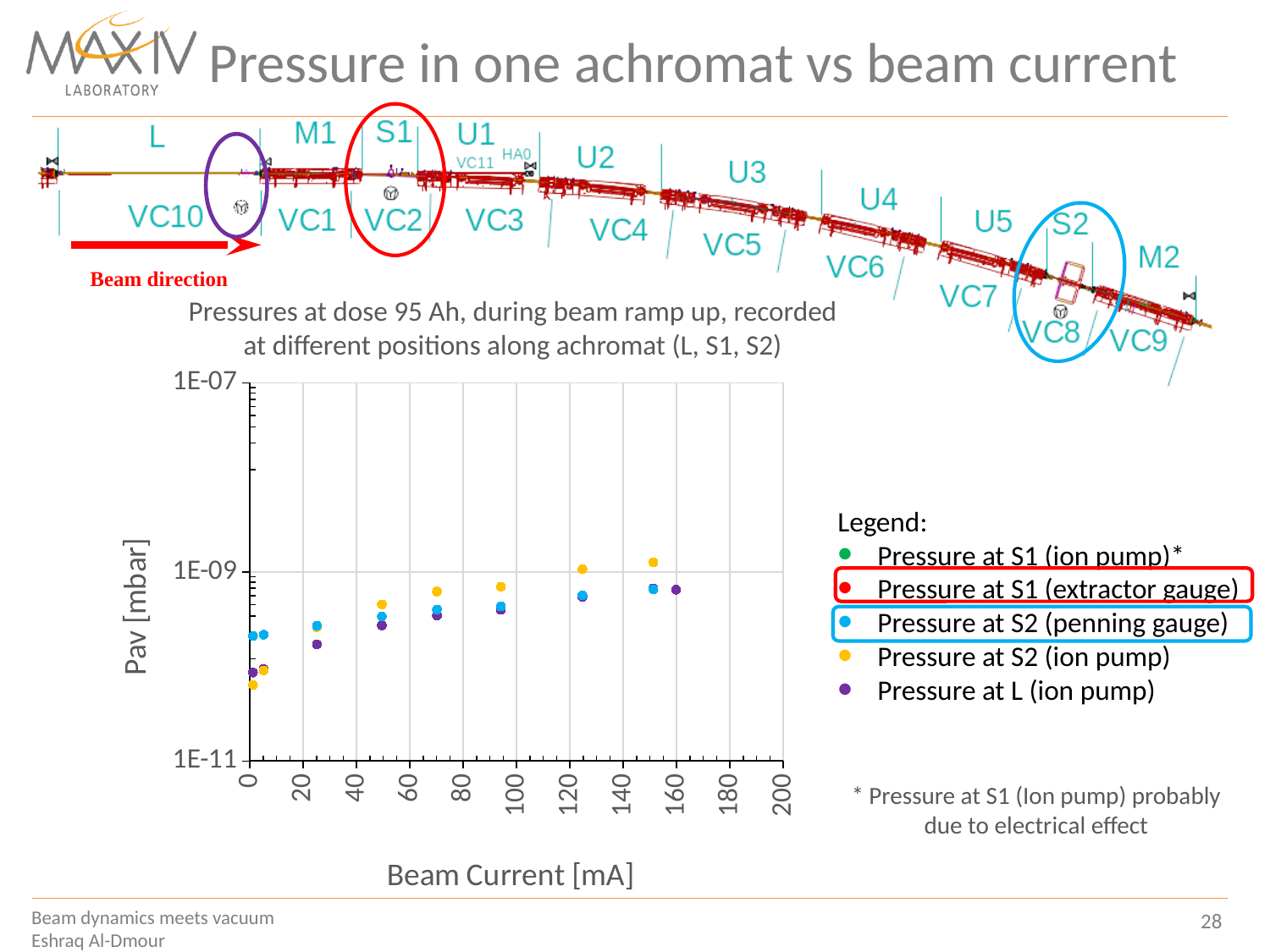
What is the label of the y axis of the chart? Pav [mbar] Which series reaches the highest pressure value on the chart? Pressure at S2 (ion pump) At 150 mA, which is larger: Pressure at S2 (ion pump) or Pressure at S2 (penning gauge)? Pressure at S2 (ion pump) As beam current increases along the x axis, do the plotted pressure values rise or fall? rise How many series does the legend list? 5 Is the value for Pressure at S2 (ion pump) at 0 mA greater or less than 1E-11? greater Is the value for Pressure at S2 (ion pump) at 150 mA greater or less than 1E-09? greater At 25 mA, which is larger: Pressure at S2 (penning gauge) or Pressure at L (ion pump)? Pressure at S2 (penning gauge) Is the value for Pressure at S2 (penning gauge) at 0 mA greater or less than 1E-09? less What kind of chart is shown on the slide? scatter chart What is the label of the x axis of the chart? Beam Current [mA]